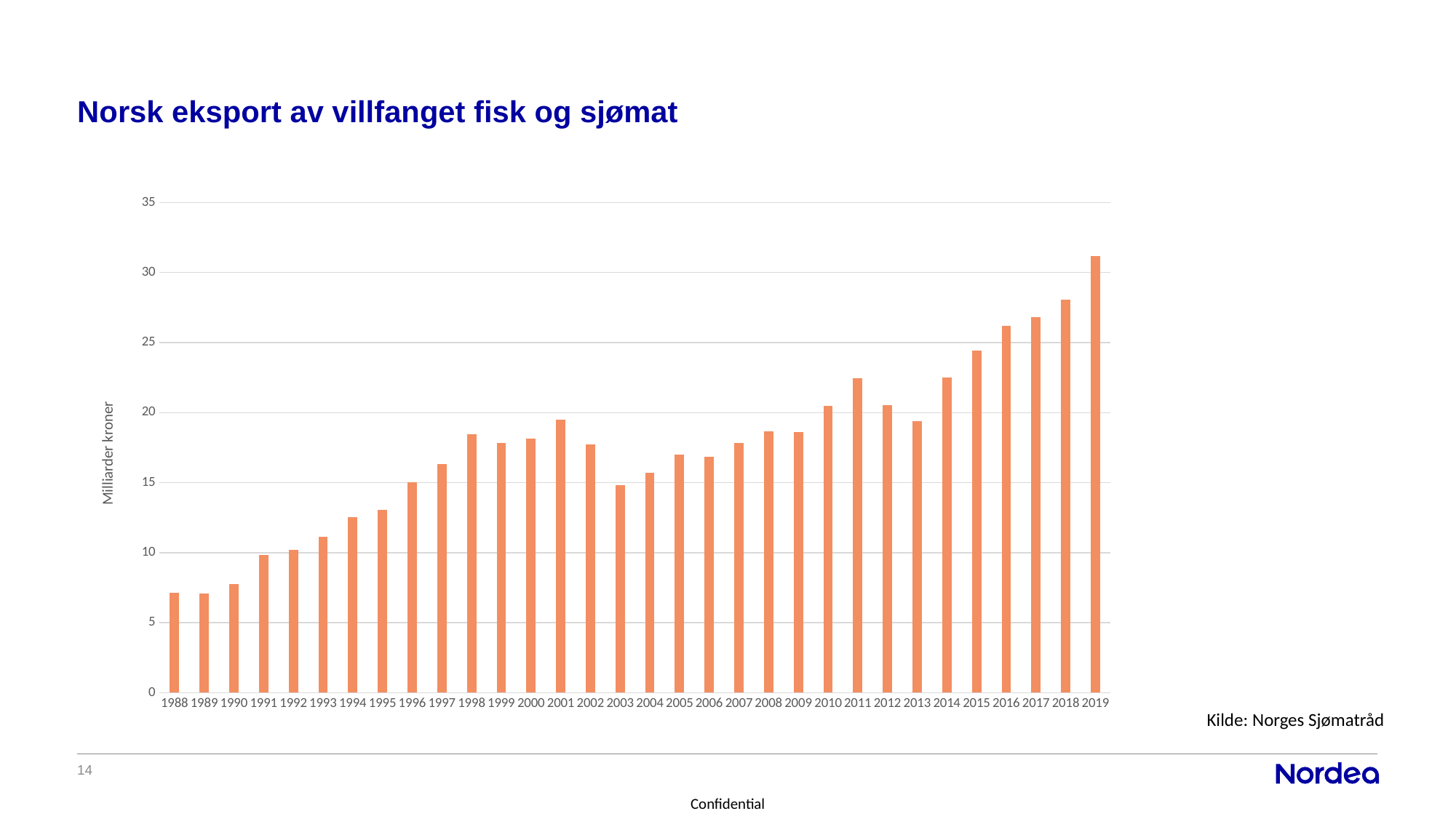
Which is larger, the value for 2001 or the value for 2003? 2001 Which is larger, the value for 2011 or the value for 2012? 2011 Is the value for 1988 greater or less than 5? greater How many years (bars) are plotted in the chart? 32 Is the value for 1995 greater or less than 10? greater Is the value for 2019 greater or less than 30? greater Do the values generally rise or fall from 1988 to 2019? Rise What is the label on the vertical axis of the chart? Milliarder kroner What kind of chart is shown on the slide? Bar chart Which year has the highest export value in the chart? 2019